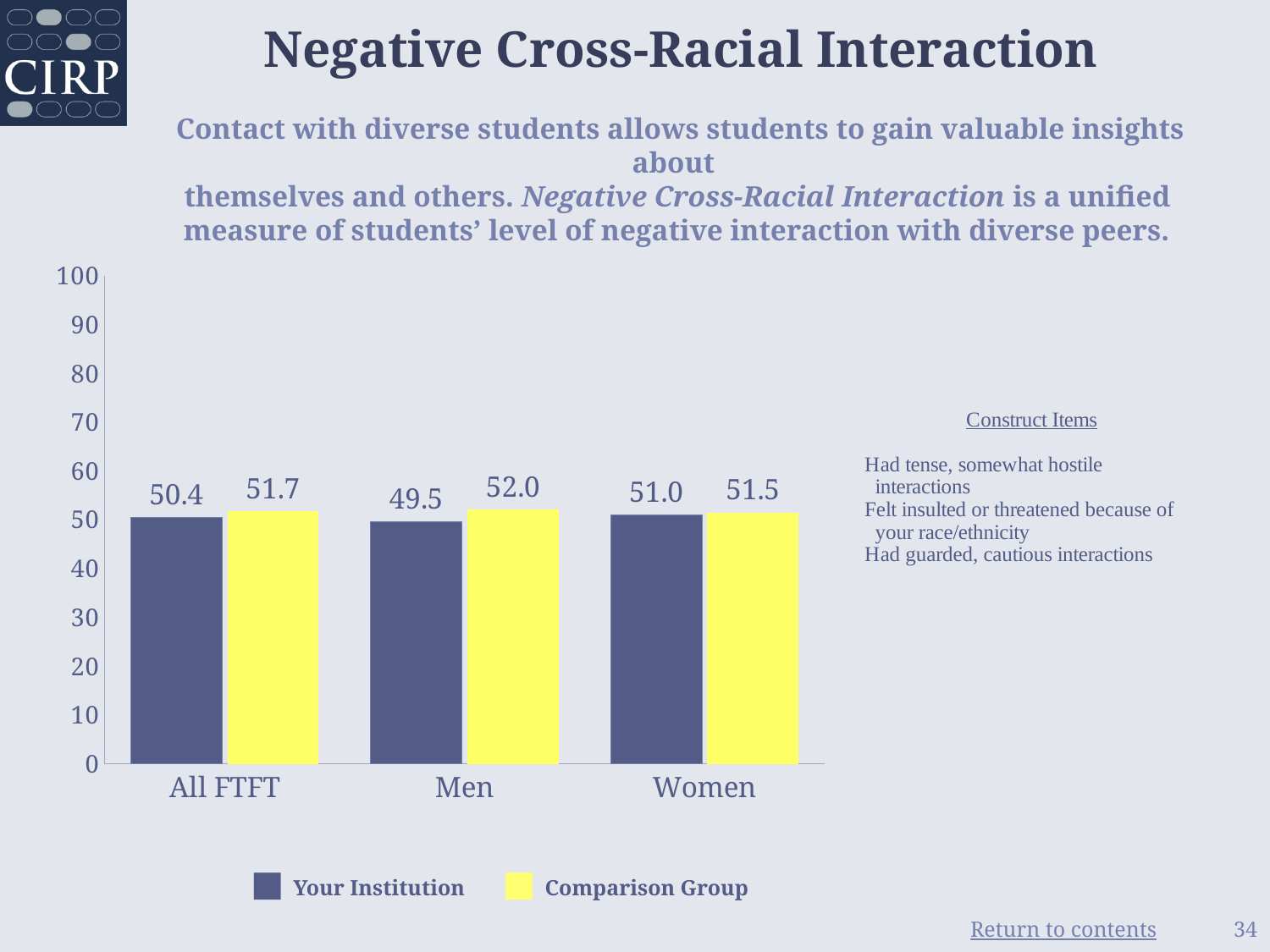
What is the value for the Comparison Group in the Women category? 51.5 What is the value for the Comparison Group in the Men category? 52.0 Which category has the lowest value for Your Institution? Men What kind of chart is shown on the slide? Bar chart What is the difference between the Comparison Group and Your Institution values in the All FTFT category? 1.3 Which category has the highest value for the Comparison Group? Men What is the difference between the Comparison Group and Your Institution values in the Men category? 2.5 In the Women category, which is larger: Your Institution or the Comparison Group? Comparison Group How many series does the legend list? 2 What is the value for Your Institution in the Women category? 51.0 What is the value for Your Institution in the All FTFT category? 50.4 How many categories are shown on the x axis? 3